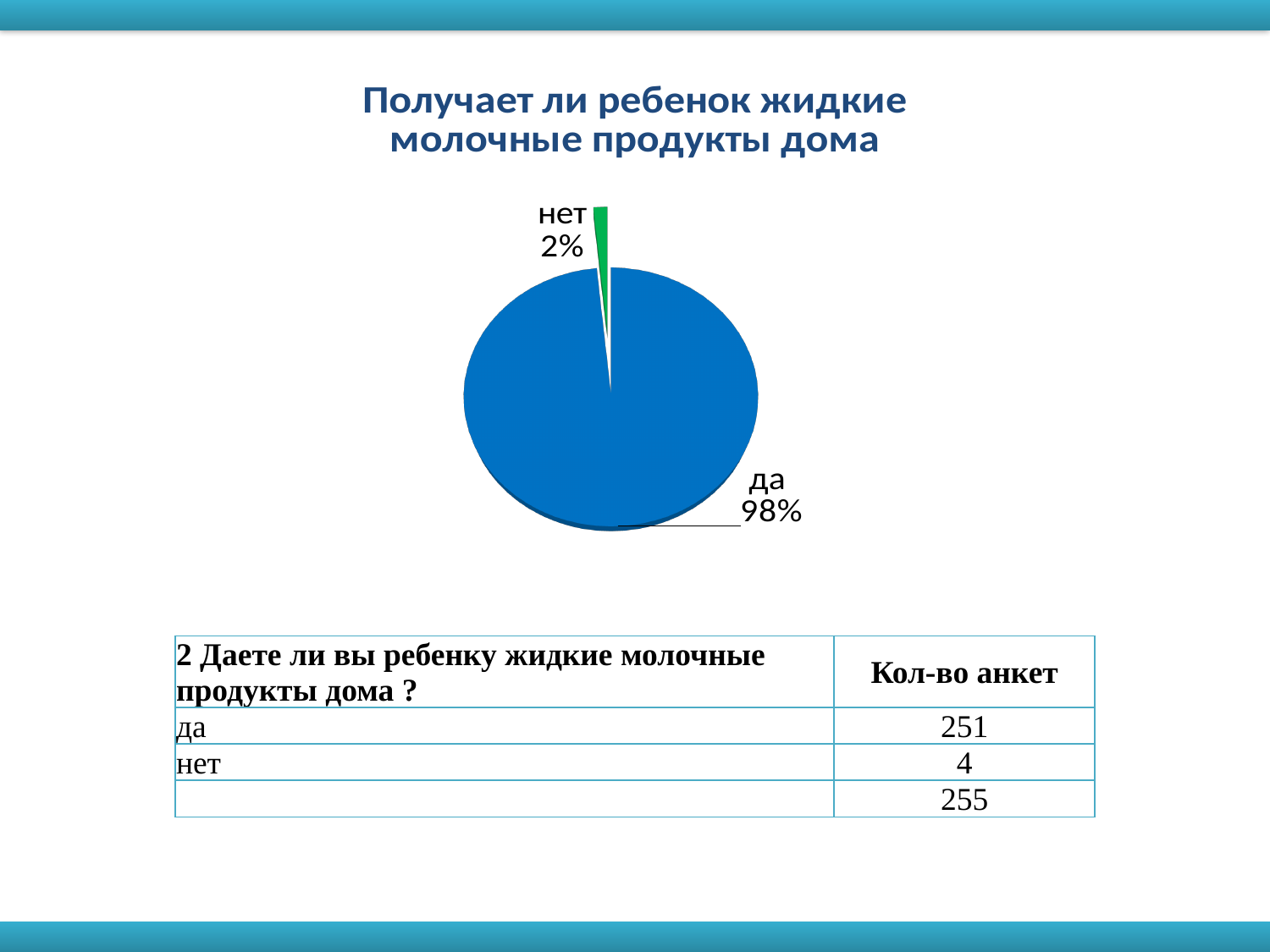
What is the difference in percentage points between the "да" and "нет" slices? 96 What is the title of the chart? Получает ли ребенок жидкие молочные продукты дома How many slices does the pie chart have? 2 Which slice is larger, "да" or "нет"? да Which slice of the pie is the smallest? нет What share of the pie does the "нет" slice represent? 2% What colour is the "нет" slice of the pie? green Which slice of the pie is the largest? да What share of the pie does the "да" slice represent? 98% What kind of chart is shown on the slide? pie chart